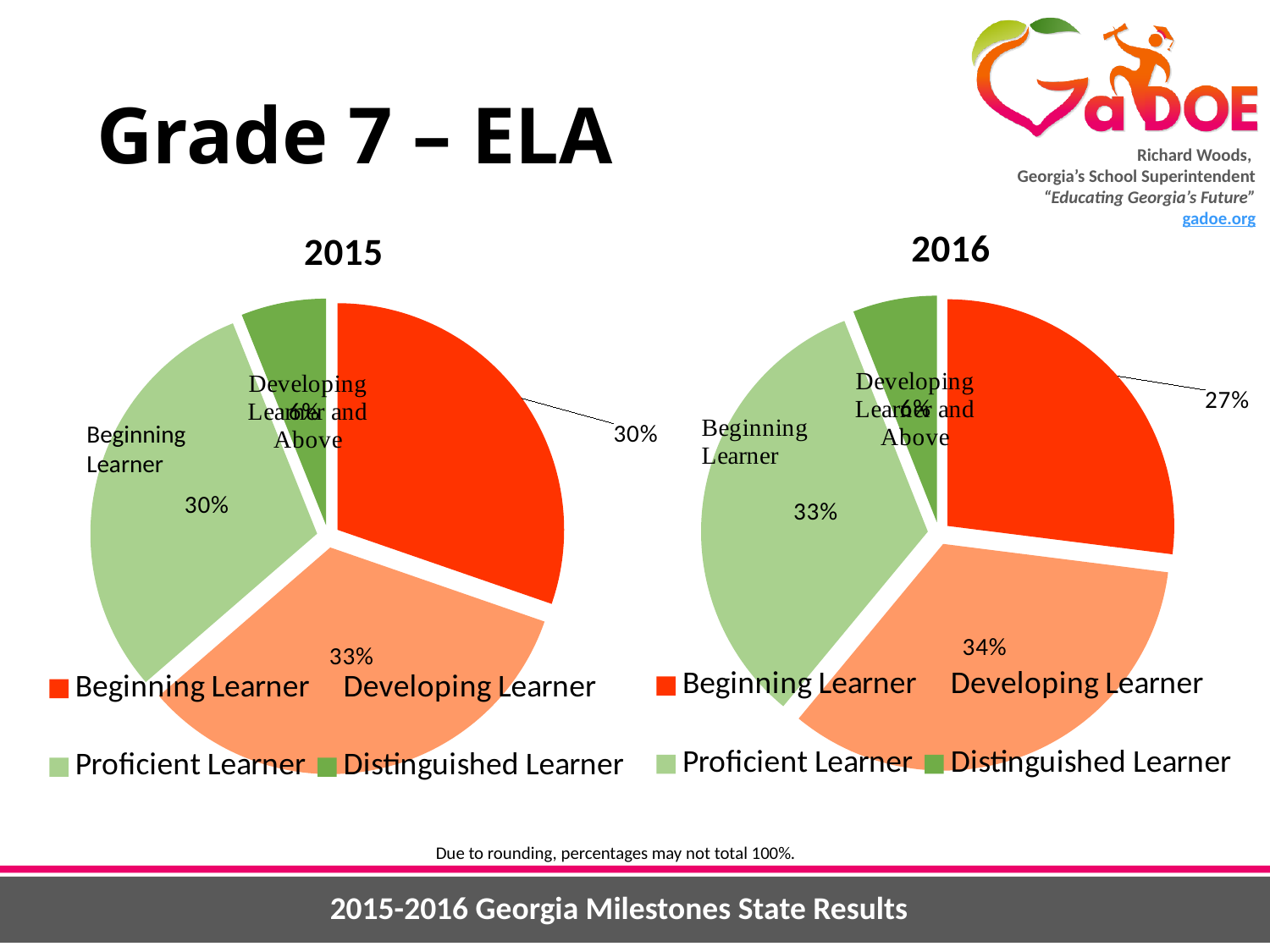
In the 2016 pie chart, which is larger: Beginning Learner or Proficient Learner? Proficient Learner What type of chart is used to show the 2015 results? Pie chart In the 2016 pie chart, what is the difference between the Developing Learner and Beginning Learner percentages? 7% In the 2016 pie chart, what percentage is shown for Beginning Learner? 27% In the 2015 pie chart, what percentage is shown for Developing Learner? 33% How many entries does the legend of the 2016 chart list? 4 In the 2015 pie chart, what percentage is shown for Distinguished Learner? 6% In the 2016 pie chart, what percentage is shown for Proficient Learner? 33% In the 2016 pie chart, which category has the largest share? Developing Learner In the 2016 pie chart, which colour represents Distinguished Learner? Dark green How many slices does the 2015 pie chart have? 4 In the 2015 pie chart, which category has the smallest share? Distinguished Learner